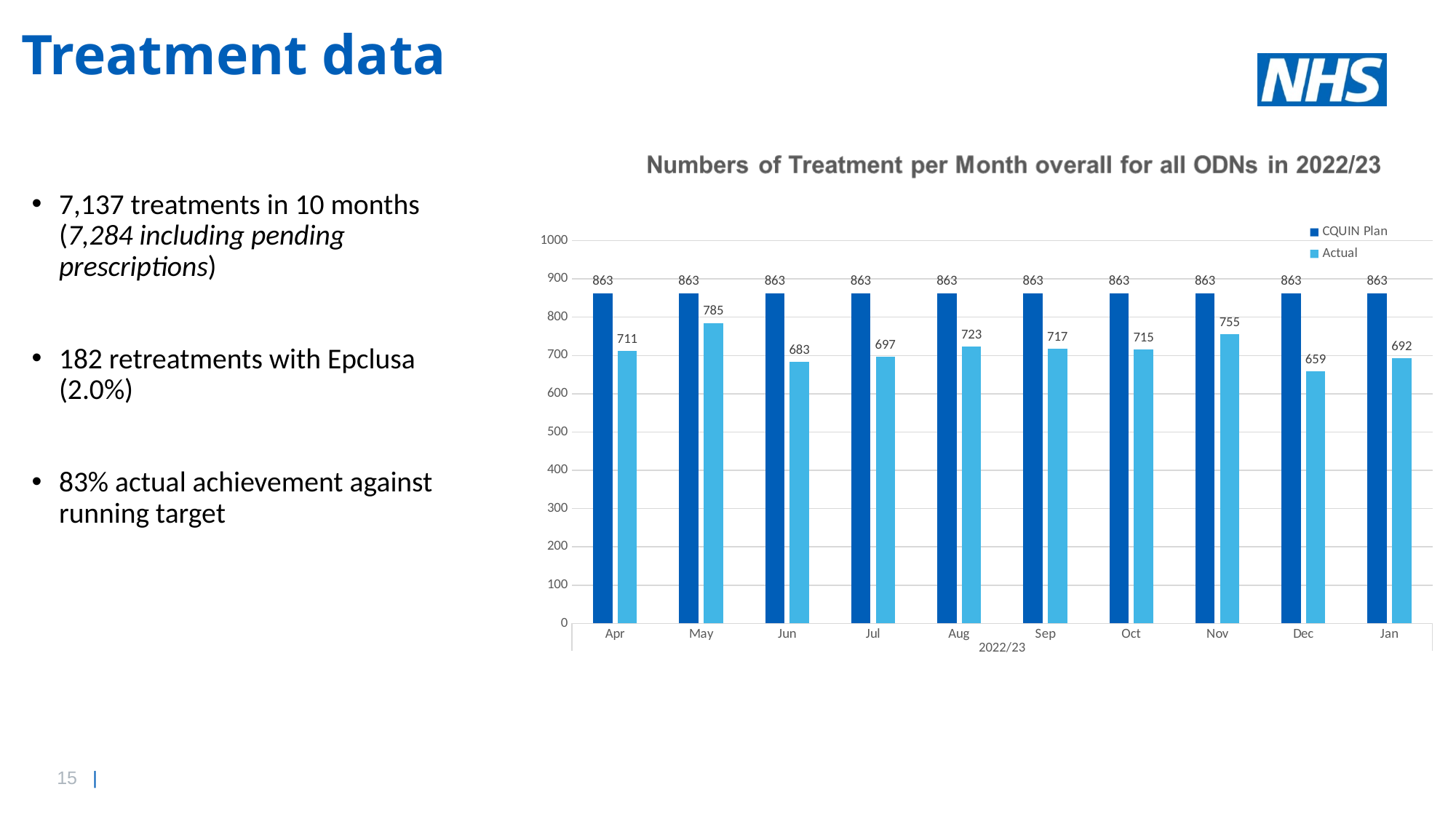
What is the CQUIN Plan value for Apr? 863 What is the difference between the CQUIN Plan and Actual values for Jun? 180 What is the title of the chart? Numbers of Treatment per Month overall for all ODNs in 2022/23 What is the Actual value for May? 785 What is the Actual value for Dec? 659 How many months are shown on the x axis? 10 Which month has the highest Actual value? May Is the Actual value for Aug greater or less than 700? greater What kind of chart is shown on the slide? Bar chart Which is larger, the Actual value for Nov or the Actual value for Jan? Nov Which month has the lowest Actual value? Dec How many series does the legend list? 2